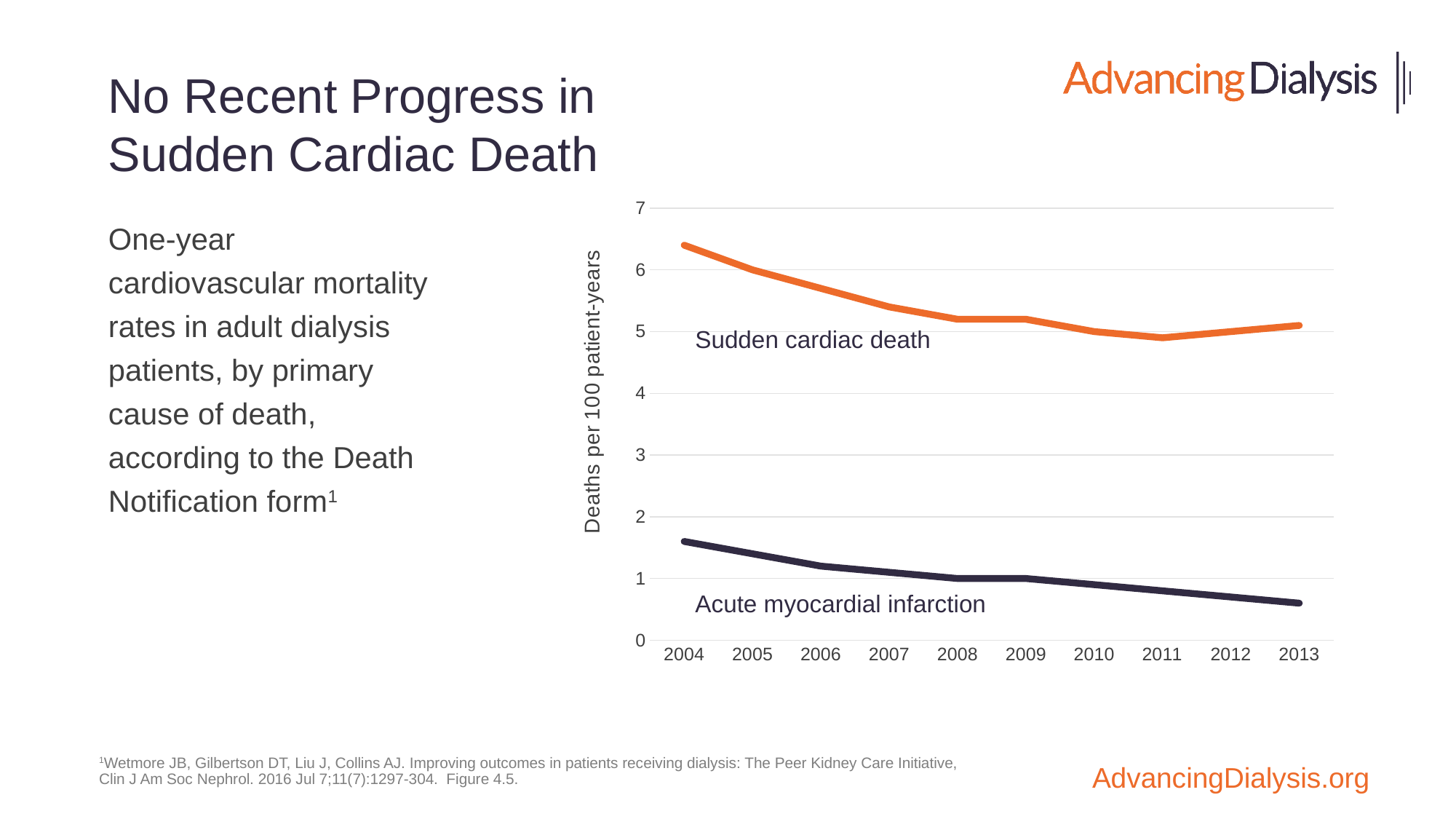
What is the label of the y axis of the chart? Deaths per 100 patient-years In which year is the Acute myocardial infarction rate lowest? 2013 In 2010, which cause of death has the higher rate, Sudden cardiac death or Acute myocardial infarction? Sudden cardiac death Is the value for Acute myocardial infarction in 2013 greater or less than 1? less How many data series are plotted in the chart? 2 Is the value for Sudden cardiac death in 2013 greater or less than 6? less Is the value for Sudden cardiac death in 2004 greater or less than 6? greater How many years are shown along the x axis of the chart? 10 In which year is the Sudden cardiac death rate highest? 2004 What kind of chart is shown on the slide? Line chart Does the Acute myocardial infarction rate rise or fall from 2004 to 2013? Fall